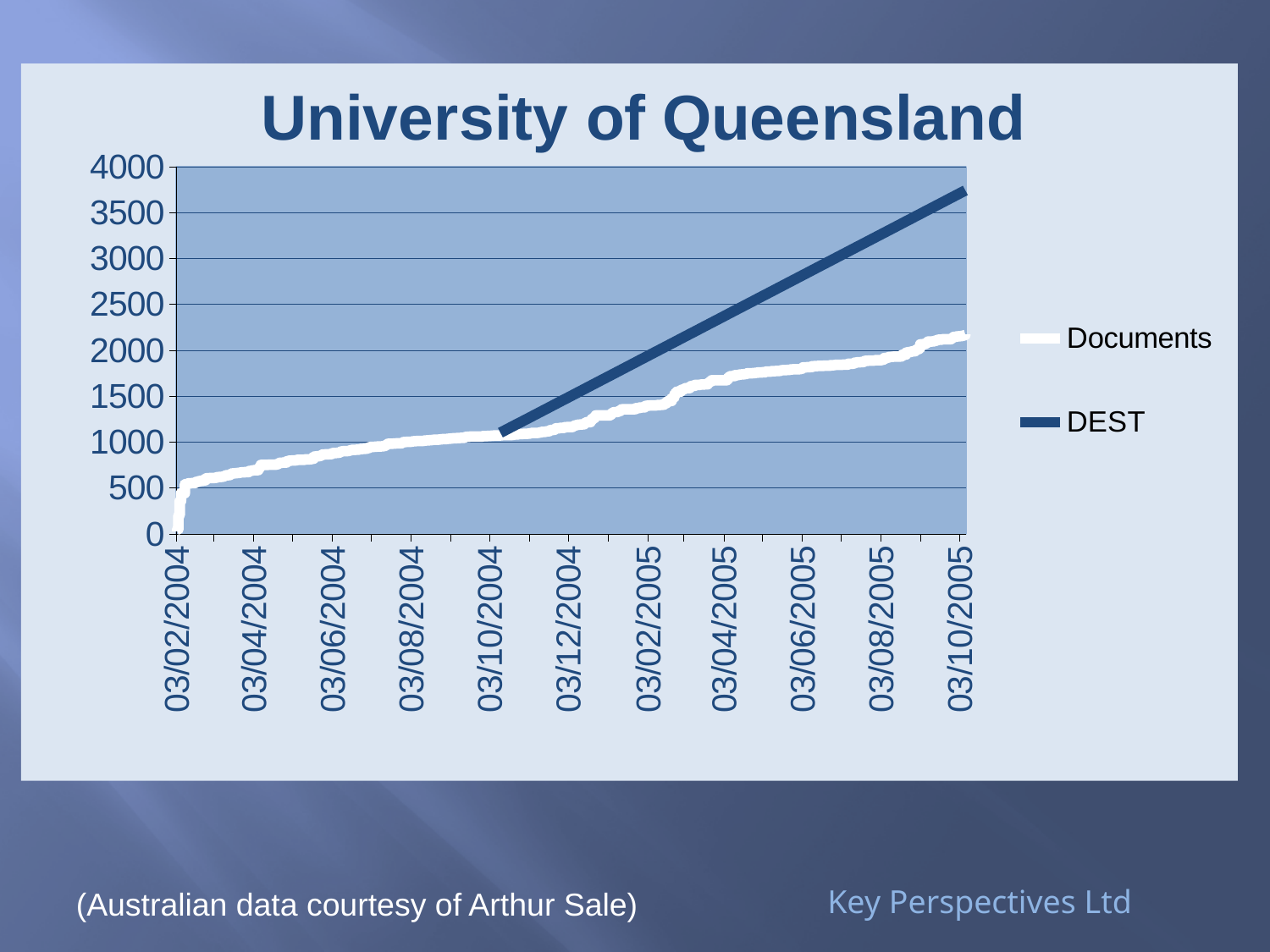
What kind of chart is shown on the slide? line chart What is the title of the chart? University of Queensland How many date labels are shown on the x axis? 11 Does the DEST series rise or fall from 03/10/2004 to 03/10/2005? rise Is the value of the Documents series at 03/10/2005 greater or less than 2000? greater Does the Documents series rise or fall over time along the x axis? rise Is the value of the DEST series at 03/06/2005 greater or less than 2500? greater How many series does the legend list? 2 Which series is drawn as a white line? Documents At 03/10/2005, which series has the higher value, Documents or DEST? DEST Is the value of the Documents series at 03/02/2005 greater or less than 1500? less